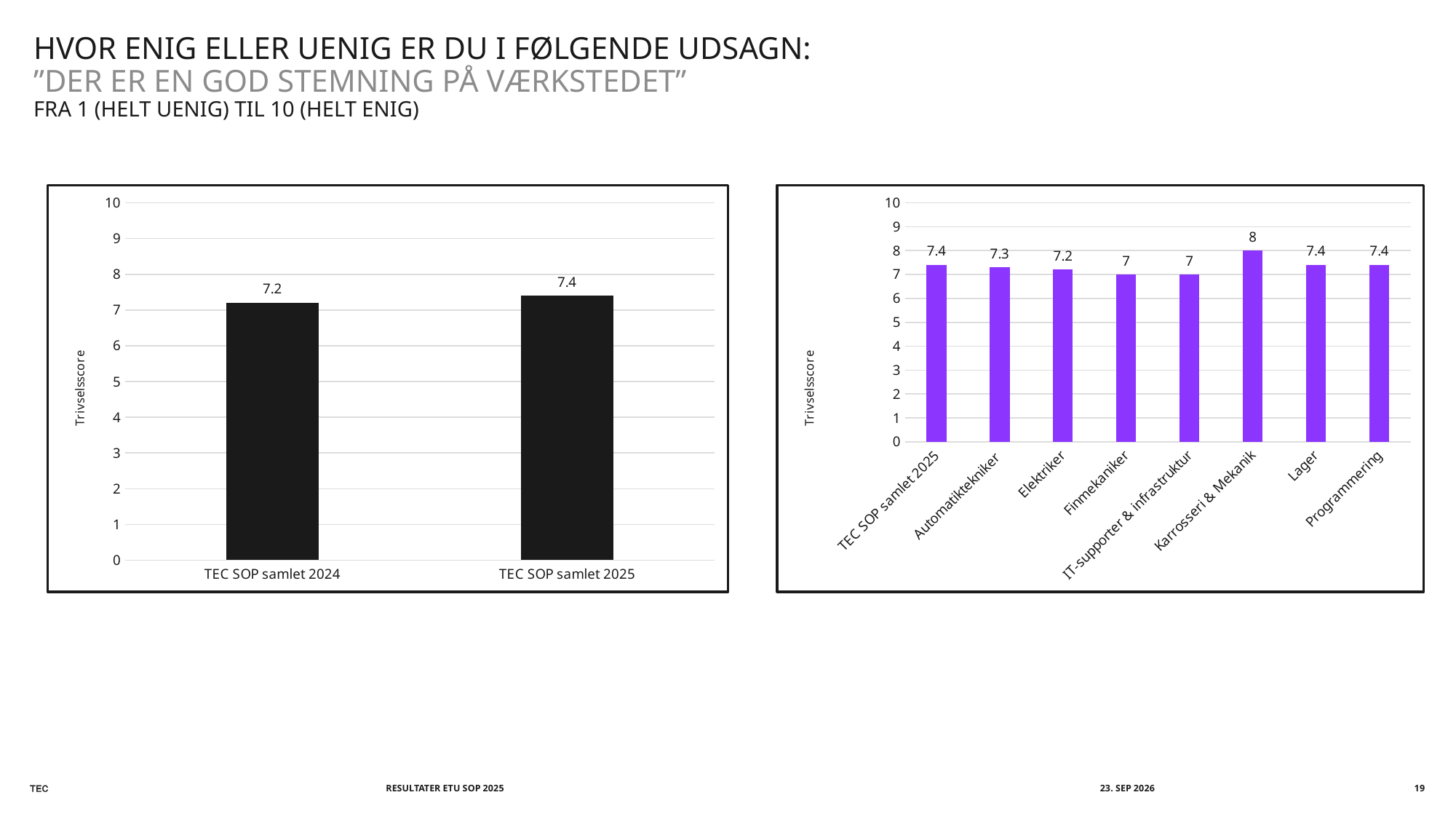
In the right chart, how many categories are shown? 8 In the right chart, what is the value for Karrosseri & Mekanik? 8 In the right chart, which category has the highest value? Karrosseri & Mekanik In the left chart, which is larger: TEC SOP samlet 2024 or TEC SOP samlet 2025? TEC SOP samlet 2025 In the right chart, what is the difference between the values for Karrosseri & Mekanik and Elektriker? 0.8 In the right chart, which is larger: Finmekaniker or Lager? Lager In the left chart, what is the value for TEC SOP samlet 2024? 7.2 In the left chart, what is the value for TEC SOP samlet 2025? 7.4 What kind of chart is the right chart? bar chart In the left chart, what is the difference between the values for TEC SOP samlet 2025 and TEC SOP samlet 2024? 0.2 In the left chart, do the values rise or fall from 2024 to 2025? rise In the right chart, what is the value for Automatiktekniker? 7.3